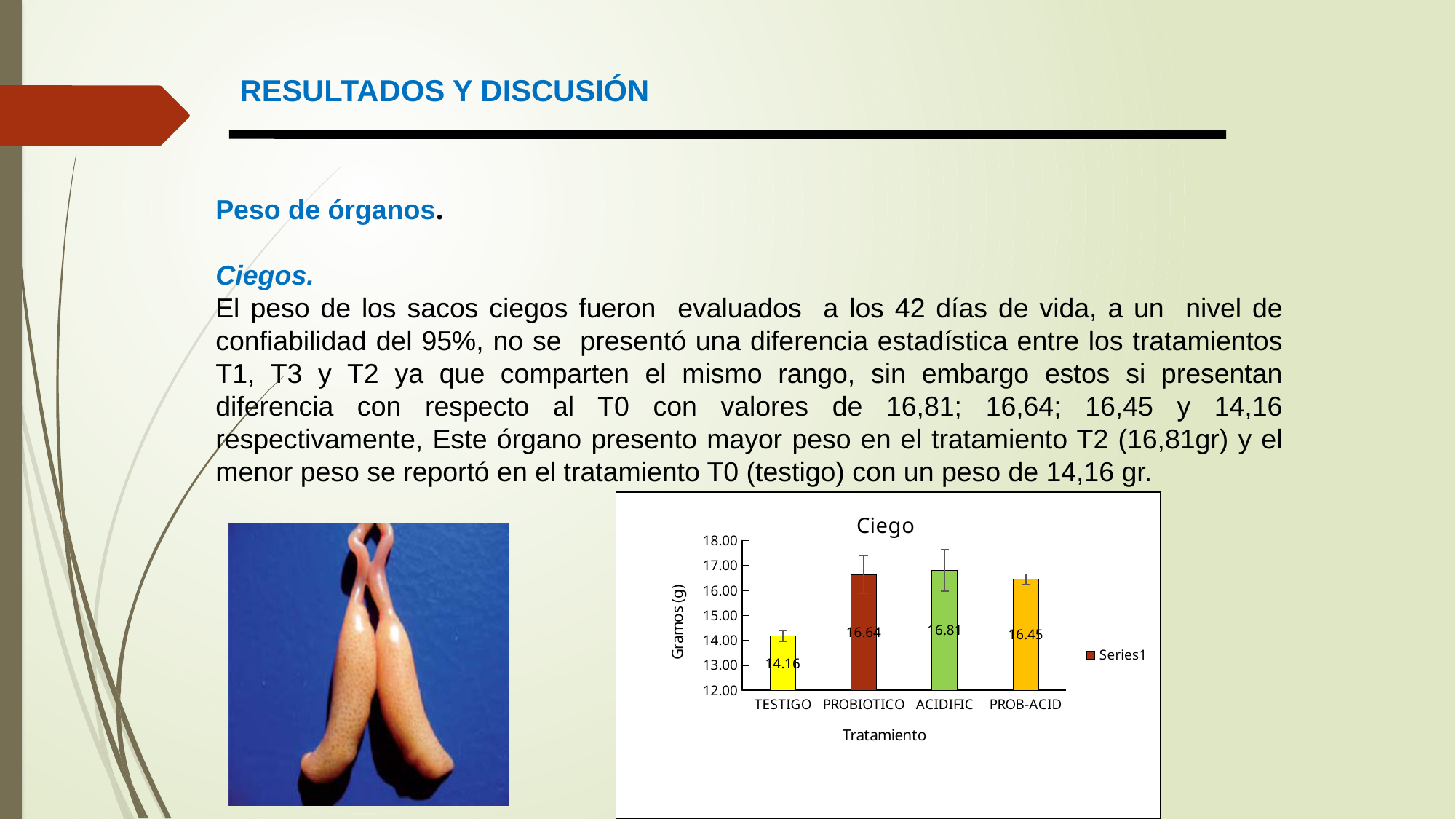
What kind of chart is the Ciego chart? bar chart Which treatment has the highest value in the Ciego chart? ACIDIFIC Which is larger in the Ciego chart, PROBIOTICO or PROB-ACID? PROBIOTICO What is the y-axis label of the Ciego chart? Gramos (g) Which treatment has the lowest value in the Ciego chart? TESTIGO Is the value for TESTIGO in the Ciego chart greater or less than 15.00? less What is the value for TESTIGO in the Ciego chart? 14.16 What is the difference between the ACIDIFIC and TESTIGO values in the Ciego chart? 2.65 What is the value for PROB-ACID in the Ciego chart? 16.45 How many treatments are shown on the x axis of the Ciego chart? 4 What is the value for ACIDIFIC in the Ciego chart? 16.81 What is the value for PROBIOTICO in the Ciego chart? 16.64